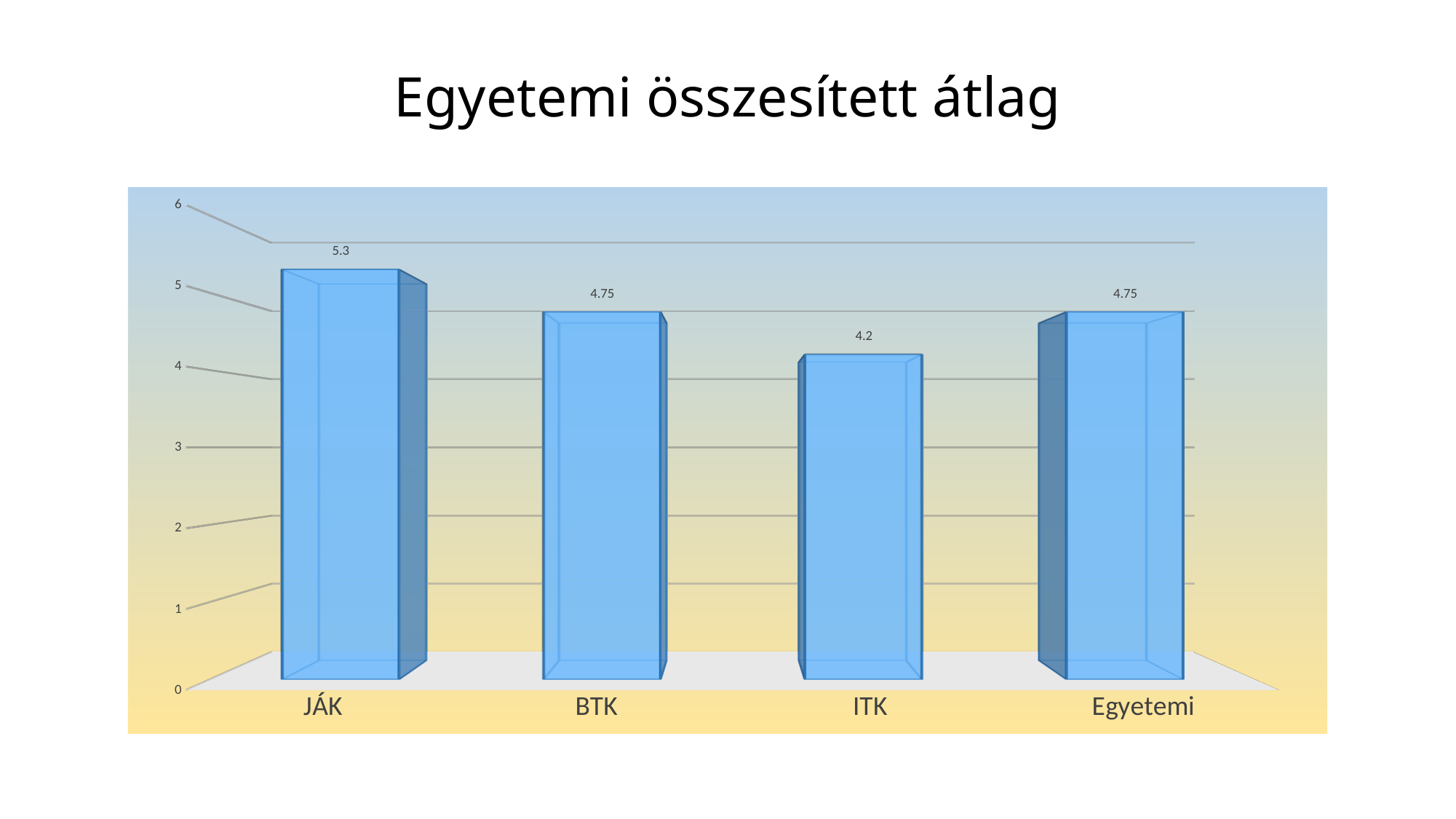
Which category has the highest value? JÁK What is the value for Egyetemi? 4.75 How many categories are shown on the x axis? 4 What kind of chart is shown on the slide? bar chart Is the value for ITK greater or less than 5? less What is the difference between the values for BTK and ITK? 0.55 Which is larger, the value for JÁK or the value for BTK? JÁK What is the value for JÁK? 5.3 What is the difference between the values for JÁK and ITK? 1.1 What is the value for ITK? 4.2 What is the value for BTK? 4.75 Which category has the lowest value? ITK